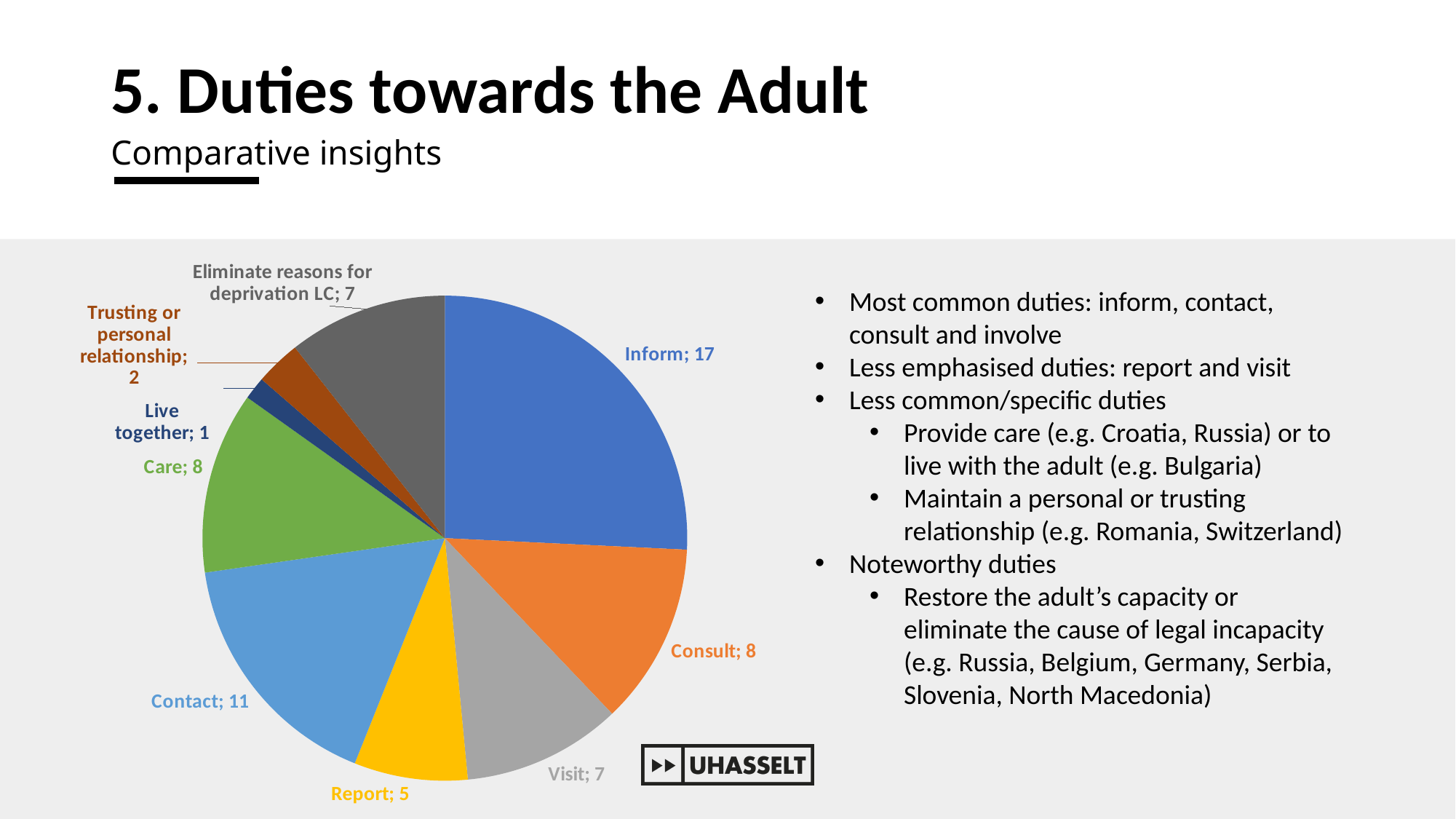
What colour is the Report slice in the pie chart? Yellow What is the difference between the values for Inform and Contact? 6 What is the difference between the values for Care and Report? 3 What is the value for Inform in the pie chart? 17 Which category has the largest slice in the pie chart? Inform What is the value for Eliminate reasons for deprivation LC in the pie chart? 7 Which is larger, the value for Consult or the value for Visit? Consult What is the value for Contact in the pie chart? 11 How many categories are shown in the pie chart? 9 Which category has the smallest slice in the pie chart? Live together What is the value for Live together in the pie chart? 1 What kind of chart is shown on the slide? Pie chart